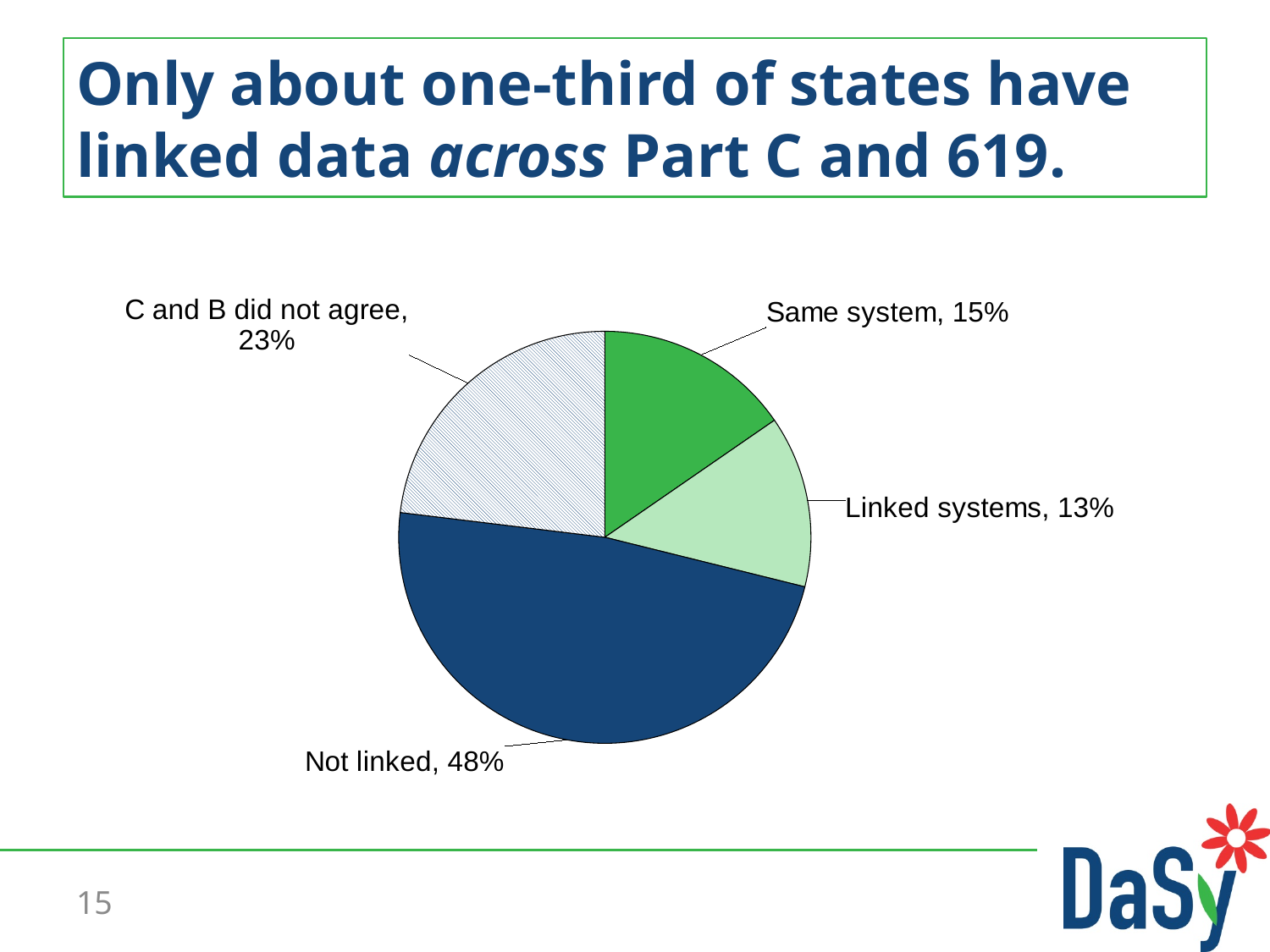
Which slice of the pie is the largest? Not linked What share of the pie is labelled "Not linked"? 48% What kind of chart is shown on the slide? pie chart Which slice of the pie is the smallest? Linked systems What is the difference in percentage points between the "Not linked" slice and the "C and B did not agree" slice? 25 What share of the pie is labelled "C and B did not agree"? 23% Which slice of the pie is drawn with a hatched pattern? C and B did not agree What is the combined share of the "Same system" and "Linked systems" slices? 28% Which is larger, the "Same system" slice or the "Linked systems" slice? Same system What share of the pie is labelled "Same system"? 15% How many slices does the pie chart have? 4